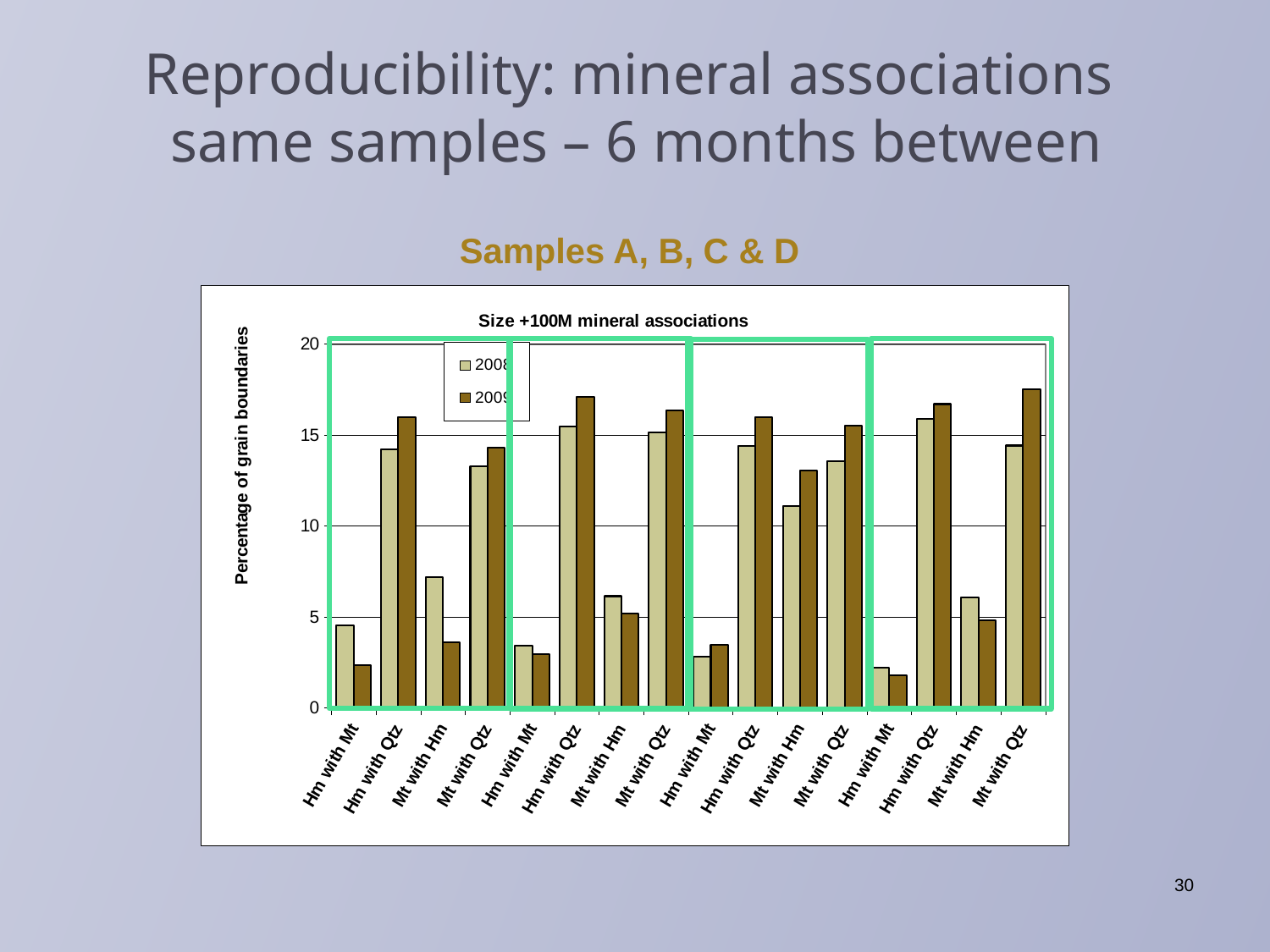
In the second group of bars from the left, is the 2009 value for Hm with Qtz greater or less than 15? greater In the third group of bars from the left, is the 2008 value for Mt with Hm greater or less than 10? greater What is the title printed above the chart's plot area? Size +100M mineral associations How many series does the legend of the chart list? 2 In the third group of bars from the left, which is larger for Mt with Hm: the 2008 value or the 2009 value? 2009 What kind of chart is shown on the slide? bar chart In the leftmost group of bars, which is larger for Mt with Hm: the 2008 value or the 2009 value? 2008 In the leftmost group of bars, which category has the highest 2009 value? Hm with Qtz How many categories are shown along the x axis of the chart? 16 In the rightmost group of bars, is the 2009 value for Hm with Mt greater or less than 5? less What are the two series named in the chart legend? 2008 and 2009